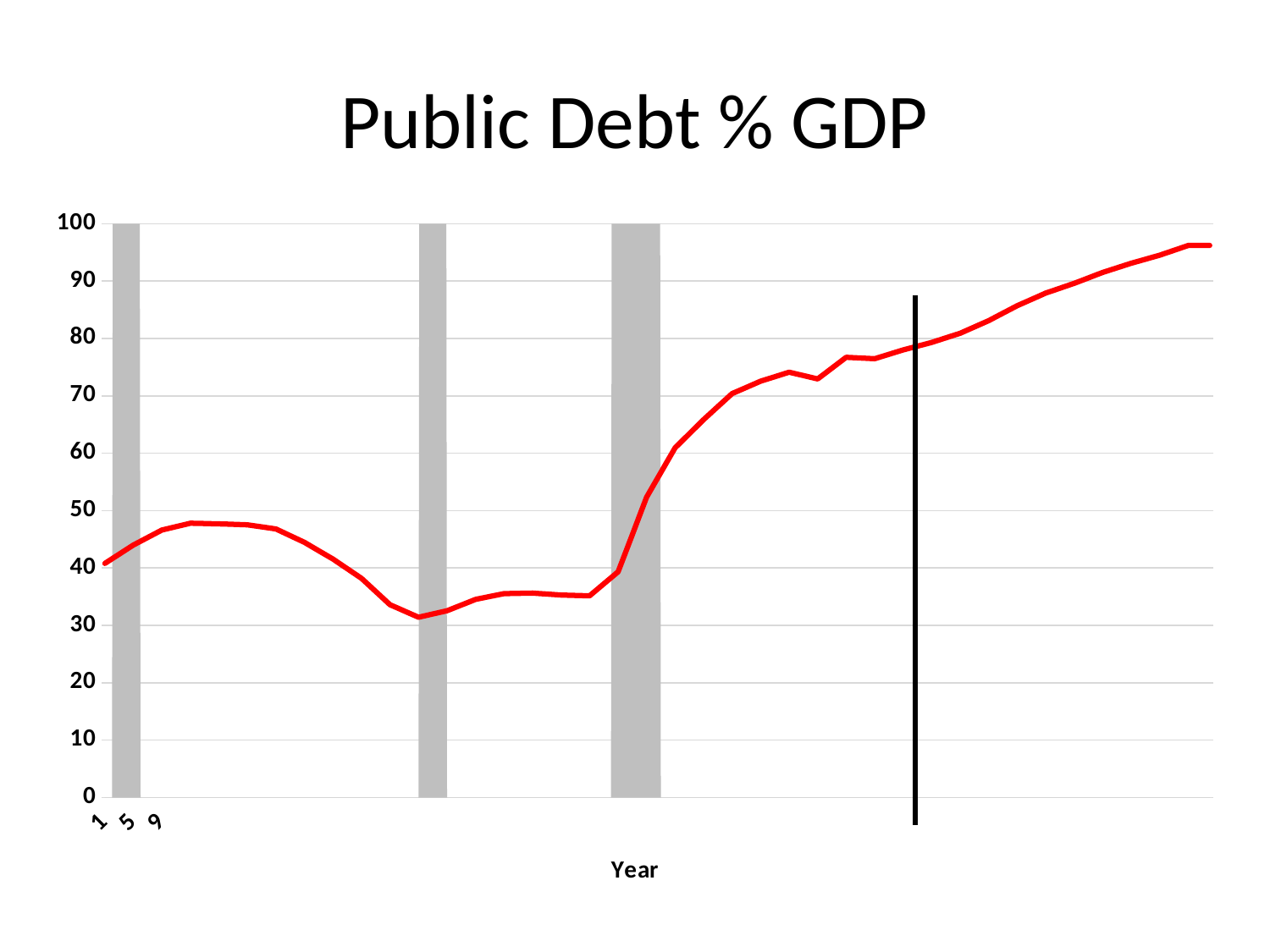
Is the lowest point of the line greater or less than 40? less What is the title of the chart? Public Debt % GDP Is the value at the left end of the line greater or less than 50? less Is the highest point of the line at the left end or the right end of the chart? right end How many lines (data series) are plotted on the chart? 1 What is the label on the x axis of the chart? Year Is the value at the right end of the line greater or less than 90? greater What is the highest value shown on the y axis of the chart? 100 How many grey shaded vertical bands are drawn on the chart? 3 Overall, does the line rise or fall from the left end of the x axis to the right end? rise What kind of chart is shown on the slide? line chart